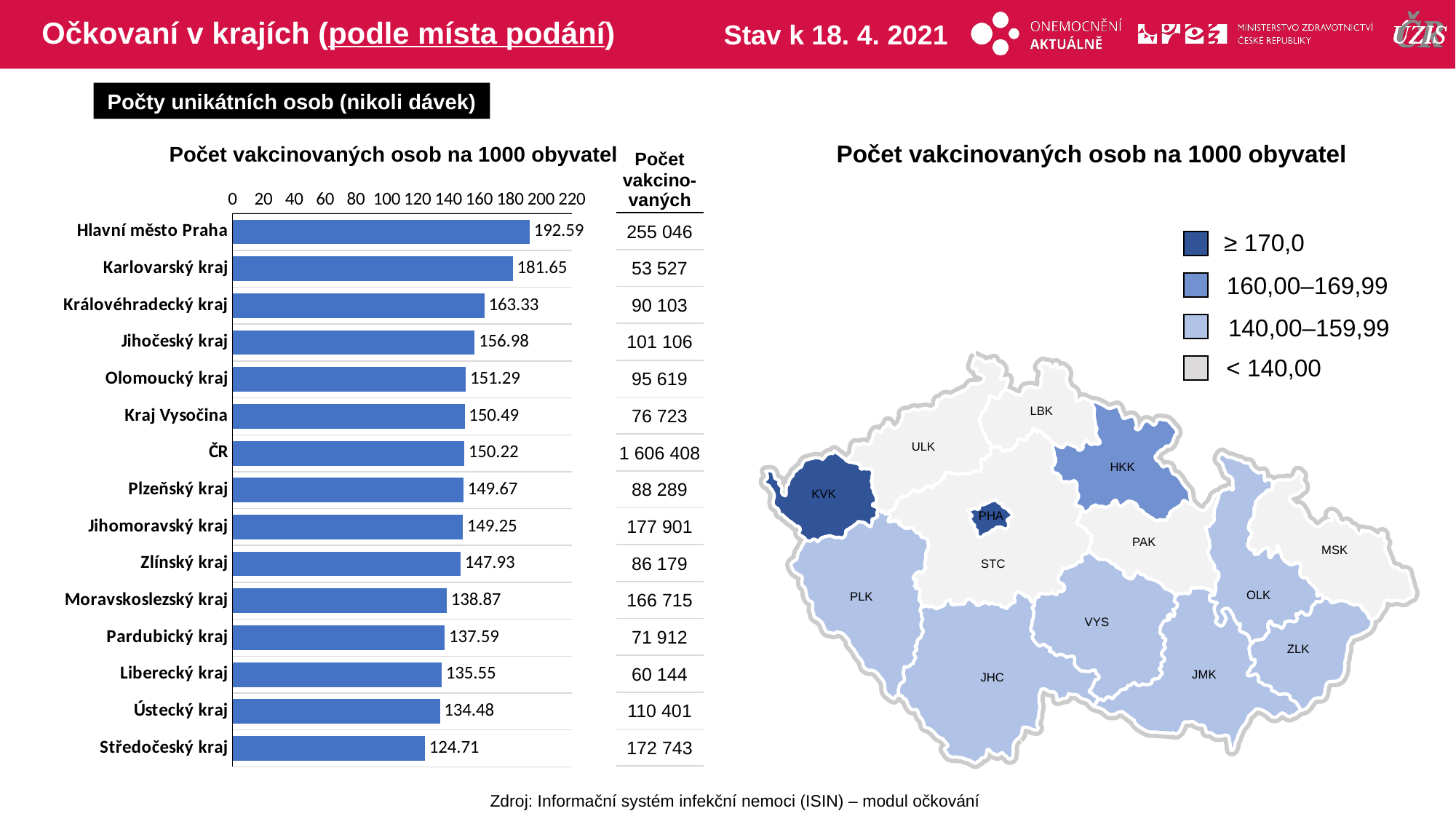
In the table column 'Počet vakcinovaných' next to the bar chart, what is the value for Karlovarský kraj? 53 527 What kind of chart is the chart on the left of the slide titled 'Počet vakcinovaných osob na 1000 obyvatel'? bar chart In the bar chart 'Počet vakcinovaných osob na 1000 obyvatel', what is the value for Jihočeský kraj? 156.98 In the bar chart 'Počet vakcinovaných osob na 1000 obyvatel', which is larger: the value for Olomoucký kraj or the value for Liberecký kraj? Olomoucký kraj In the bar chart 'Počet vakcinovaných osob na 1000 obyvatel', what is the value for ČR? 150.22 In the bar chart 'Počet vakcinovaných osob na 1000 obyvatel', is the value for Moravskoslezský kraj greater or less than 140? less How many categories (bars) does the bar chart 'Počet vakcinovaných osob na 1000 obyvatel' show? 15 In the bar chart 'Počet vakcinovaných osob na 1000 obyvatel', which category has the highest value? Hlavní město Praha In the bar chart 'Počet vakcinovaných osob na 1000 obyvatel', what is the difference between the values for Hlavní město Praha and Karlovarský kraj? 10.94 In the bar chart 'Počet vakcinovaných osob na 1000 obyvatel', what is the value for Hlavní město Praha? 192.59 In the bar chart 'Počet vakcinovaných osob na 1000 obyvatel', which category has the lowest value? Středočeský kraj In the map legend on the right of the slide, what range does the darkest blue colour represent? ≥ 170,0